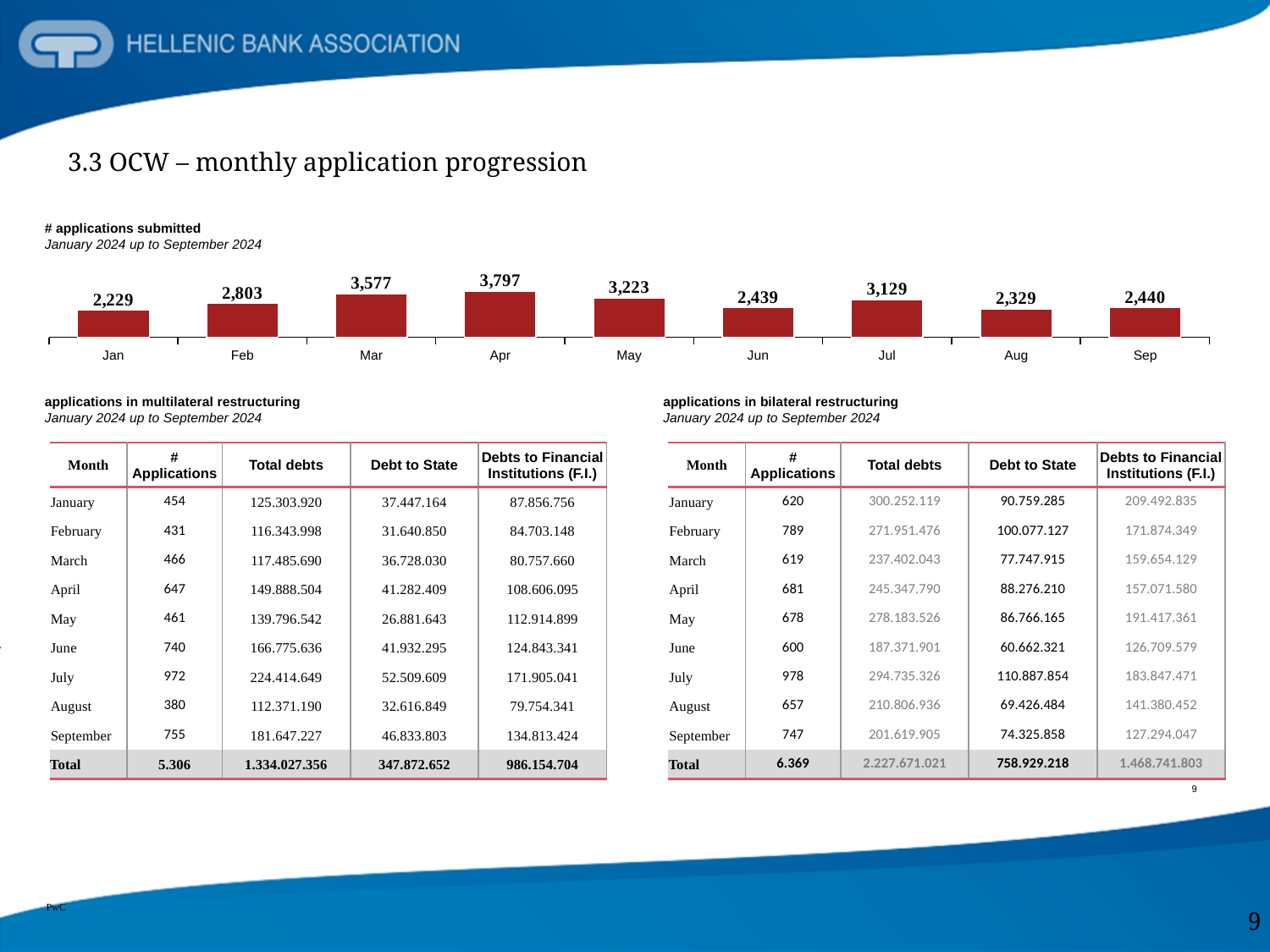
How many months are shown in the '# applications submitted' chart? 9 In the '# applications submitted' chart, which is larger, the value for May or the value for July? May What type of chart is the '# applications submitted' chart? Bar chart In the '# applications submitted' chart, which month has the highest number of applications? Apr In the '# applications submitted' chart, what is the difference between the values for March and February? 774 In the '# applications submitted' chart, which is larger, the value for June or the value for September? Sep In the '# applications submitted' chart, what is the difference between the values for April and January? 1,568 In the '# applications submitted' chart, what is the value for January? 2,229 In the '# applications submitted' chart, how many applications were submitted in April? 3,797 In the '# applications submitted' chart, do the values rise or fall from January to April? Rise In the '# applications submitted' chart, which month has the lowest number of applications? Jan In the '# applications submitted' chart, what is the value for July? 3,129